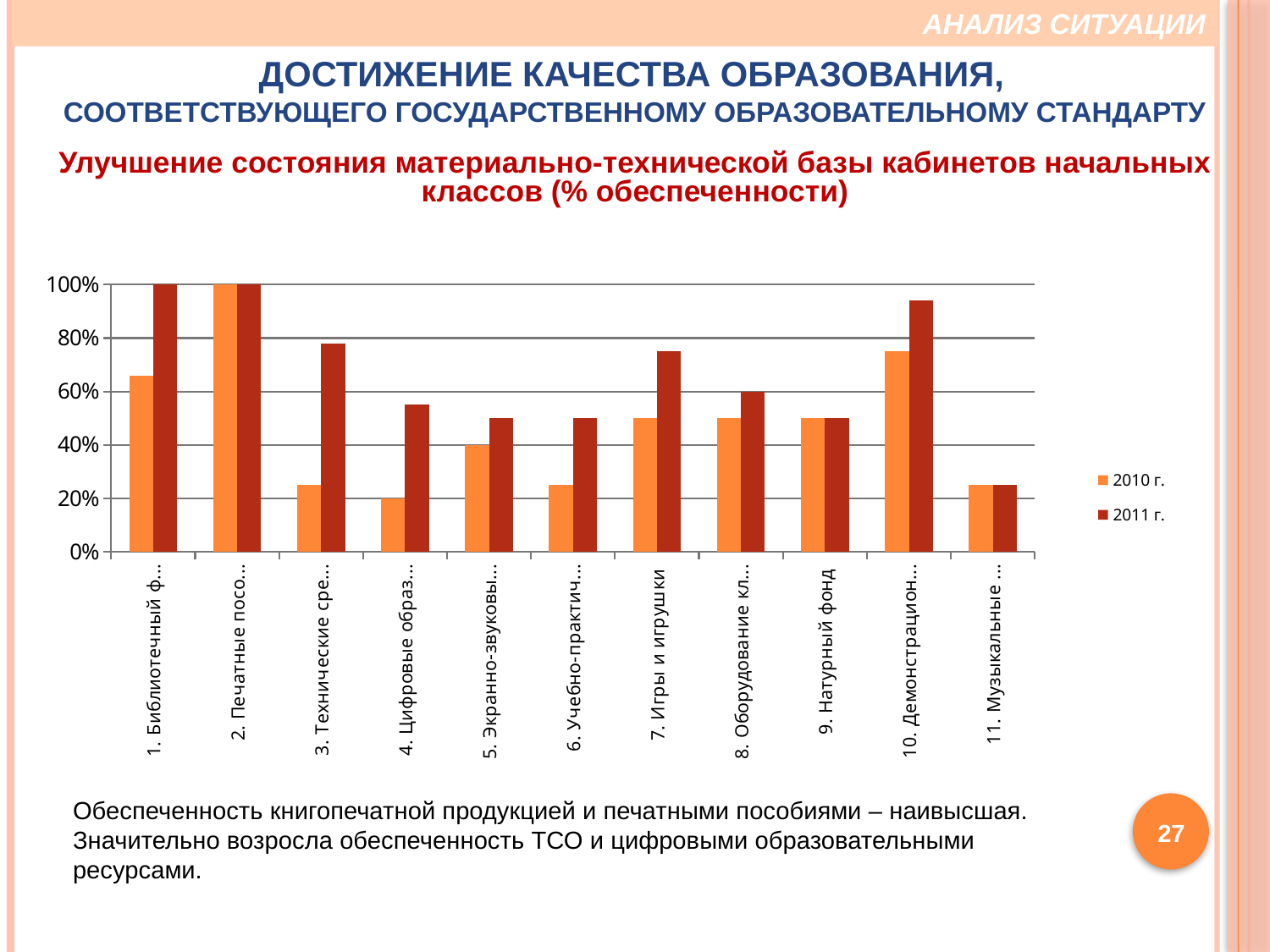
What is the 2011 г. value for category 8 (Оборудование кл...)? 60% What is the 2010 г. value for category 5 (Экранно-звуковы...)? 40% What is the 2011 г. value for category 2 (Печатные посо...)? 100% Is the 2011 г. value for category 7 (Игры и игрушки) greater or less than 60%? greater What are the two series named in the legend? 2010 г. and 2011 г. What kind of chart is shown on the slide? bar chart Which category has the highest 2010 г. value? 2. Печатные посо... Is the 2011 г. value for category 10 (Демонстрацион...) greater or less than 80%? greater How many categories are plotted along the x axis? 11 What is the 2010 г. value for category 4 (Цифровые образ...)? 20% For category 3 (Технические сре...), which series has the larger value, 2010 г. or 2011 г.? 2011 г. How many series does the legend list? 2